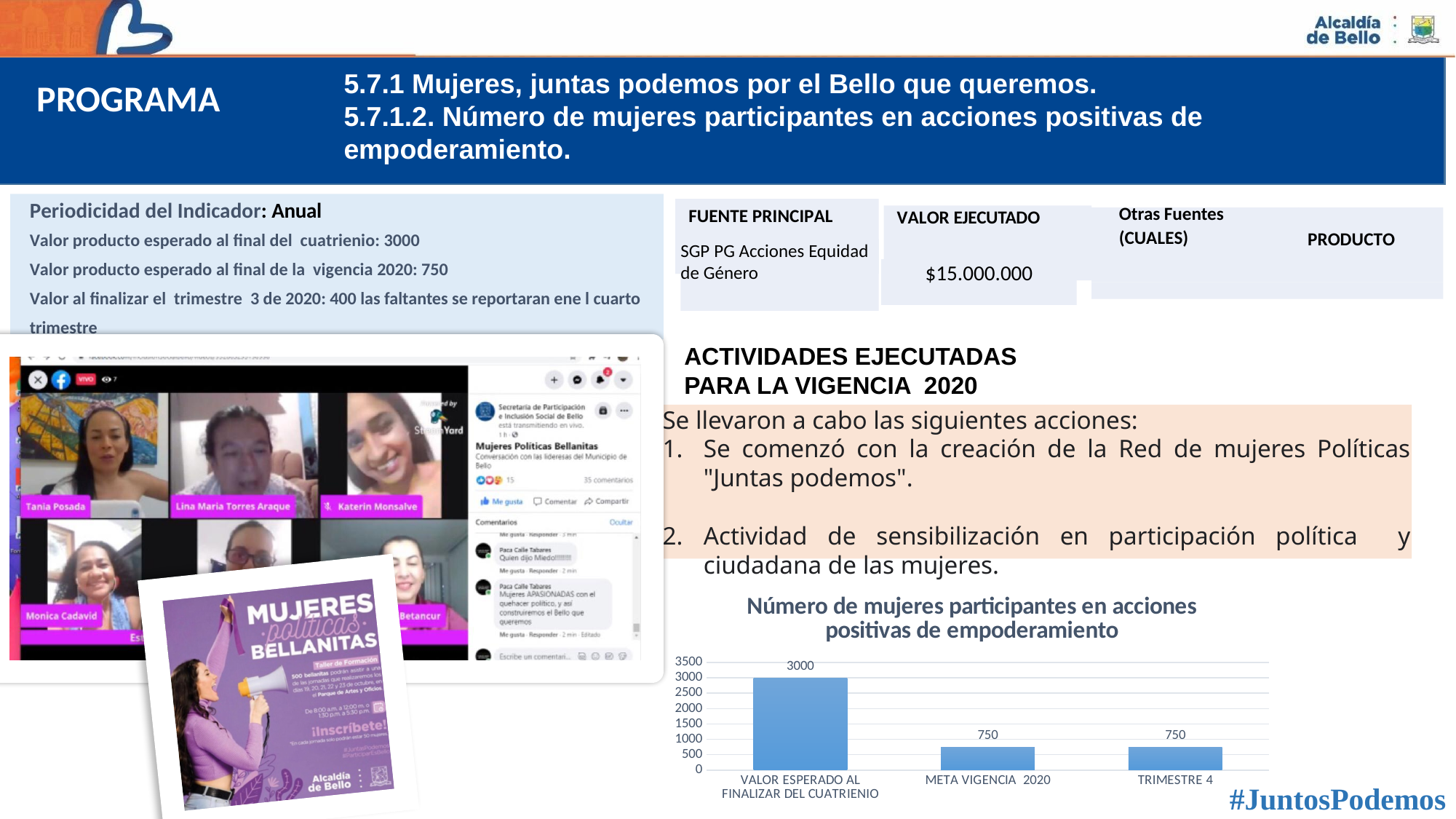
Is the value for META VIGENCIA 2020 greater or less than 1000? less What is the value for META VIGENCIA 2020 in the chart? 750 What is the lowest value shown in the chart? 750 What is the value for TRIMESTRE 4 in the chart? 750 Is the value for VALOR ESPERADO AL FINALIZAR DEL CUATRIENIO greater or less than 2500? greater What kind of chart is shown on the slide? bar chart How many categories are shown in the chart? 3 Which is larger, the value for VALOR ESPERADO AL FINALIZAR DEL CUATRIENIO or the value for TRIMESTRE 4? VALOR ESPERADO AL FINALIZAR DEL CUATRIENIO What is the value for VALOR ESPERADO AL FINALIZAR DEL CUATRIENIO in the chart? 3000 Which category has the highest value in the chart? VALOR ESPERADO AL FINALIZAR DEL CUATRIENIO What is the difference between the value for VALOR ESPERADO AL FINALIZAR DEL CUATRIENIO and the value for META VIGENCIA 2020? 2250 What is the title of the chart? Número de mujeres participantes en acciones positivas de empoderamiento